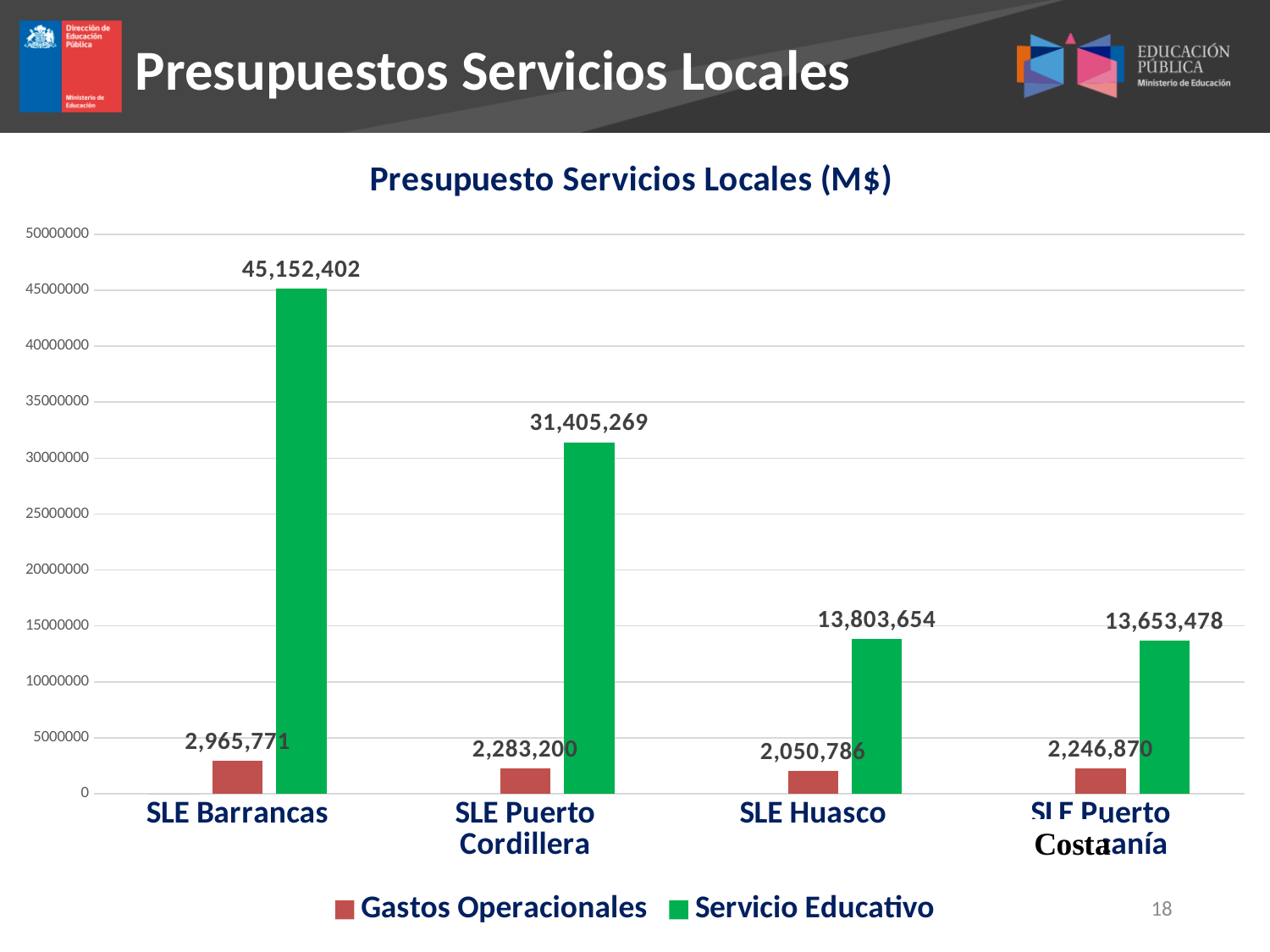
What is the Gastos Operacionales value for SLE Huasco? 2,050,786 Is the Servicio Educativo value for SLE Huasco greater or less than 15000000? less What is the Servicio Educativo value for SLE Puerto Cordillera? 31,405,269 What is the Servicio Educativo value for SLE Barrancas? 45,152,402 What is the difference between the Servicio Educativo values for SLE Barrancas and SLE Puerto Cordillera? 13,747,133 Which category has the highest Servicio Educativo value? SLE Barrancas Which category has the lowest Gastos Operacionales value? SLE Huasco How many series does the legend list? 2 How many categories are shown on the x axis of the chart? 4 What is the difference between the Gastos Operacionales values for SLE Barrancas and SLE Huasco? 914,985 Which is larger, the Gastos Operacionales value for SLE Barrancas or for SLE Puerto Cordillera? SLE Barrancas What kind of chart is shown on the slide? bar chart